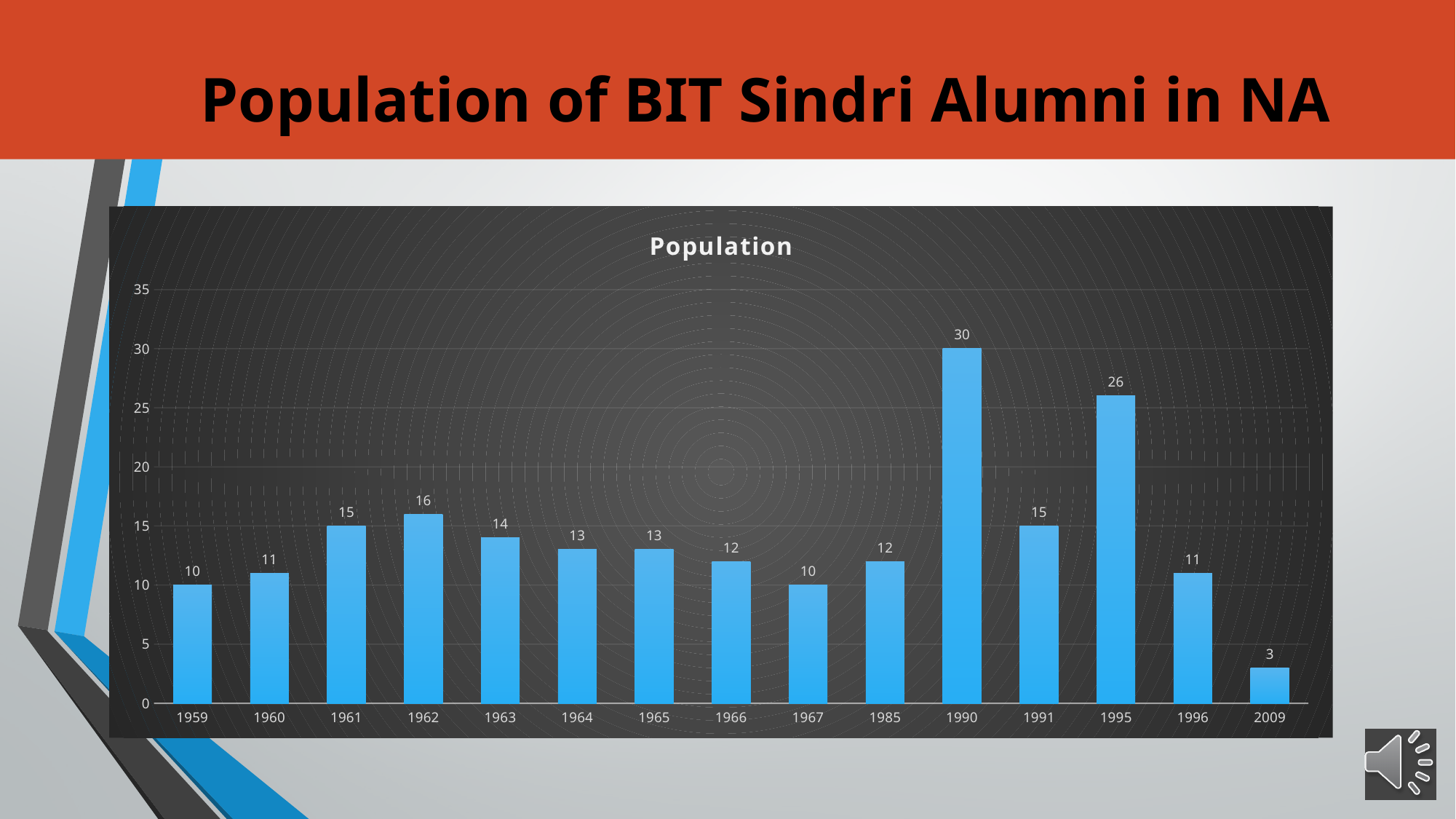
Do the values rise or fall from 1962 to 1967? fall What kind of chart is shown on the slide? bar chart What is the difference between the population values for 1990 and 1995? 4 Is the value for 1995 greater or less than 20? greater Which year has the highest population? 1990 What is the population value for 2009? 3 Which has a larger population value, 1961 or 1963? 1961 What is the title of the chart? Population What is the population value for 1990? 30 What is the population value for 1962? 16 How many years are shown on the x axis? 15 Which year has the lowest population? 2009